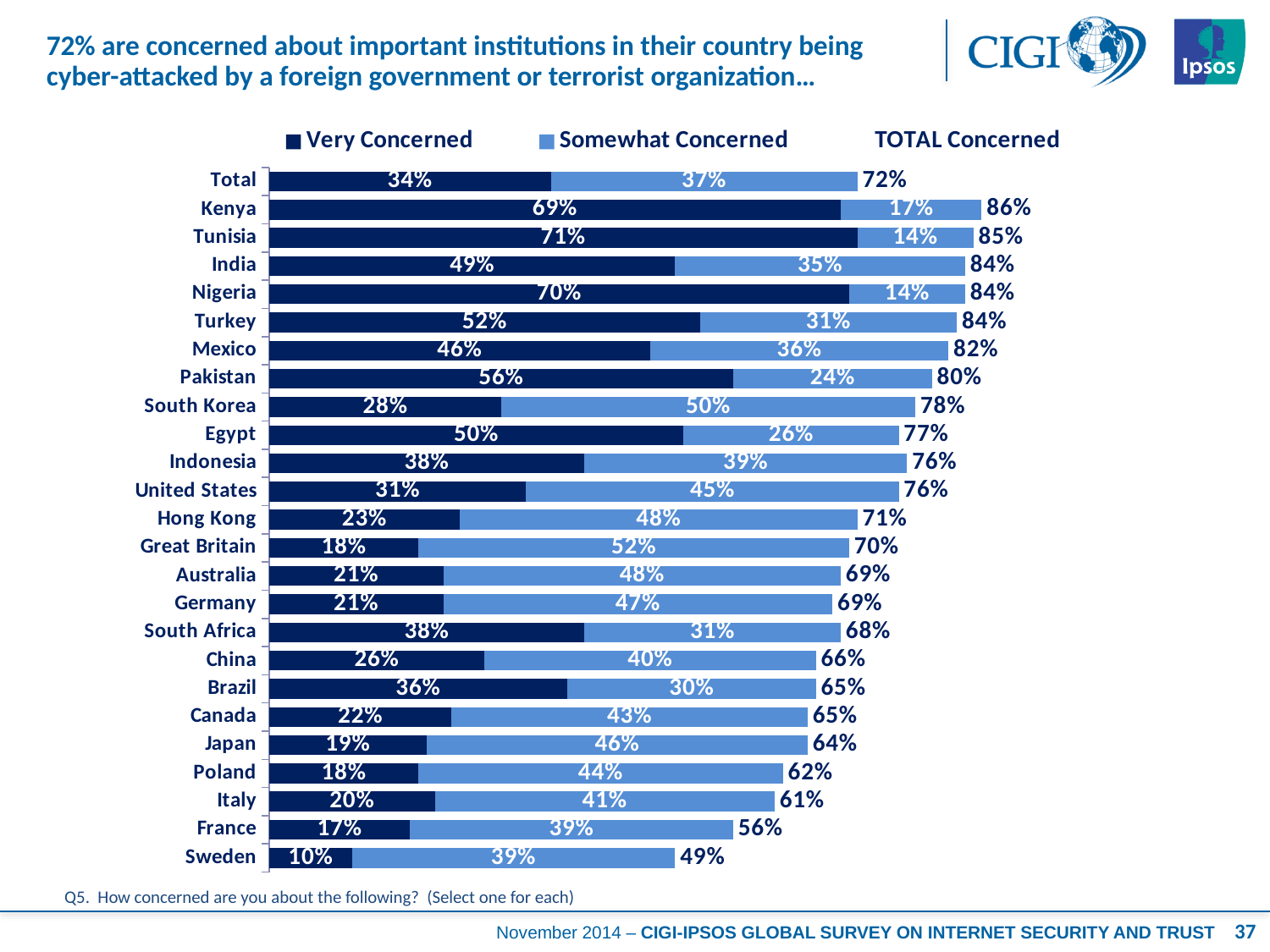
Which has a larger Very Concerned value, Tunisia or Nigeria? Tunisia What is the difference between the TOTAL Concerned values for Kenya and Sweden? 37% What is the Very Concerned value for Kenya? 69% What kind of chart is shown on the slide? Stacked bar chart What is the Somewhat Concerned value for South Korea? 50% Which country has the lowest Very Concerned value? Sweden How many series does the legend list? 3 How many countries (excluding Total) are shown in the chart? 24 What is the total of the stacked bar for Mexico? 82% Which colour represents the Very Concerned series? Dark blue What is the TOTAL Concerned value for Sweden? 49% Which country has the highest TOTAL Concerned value? Kenya